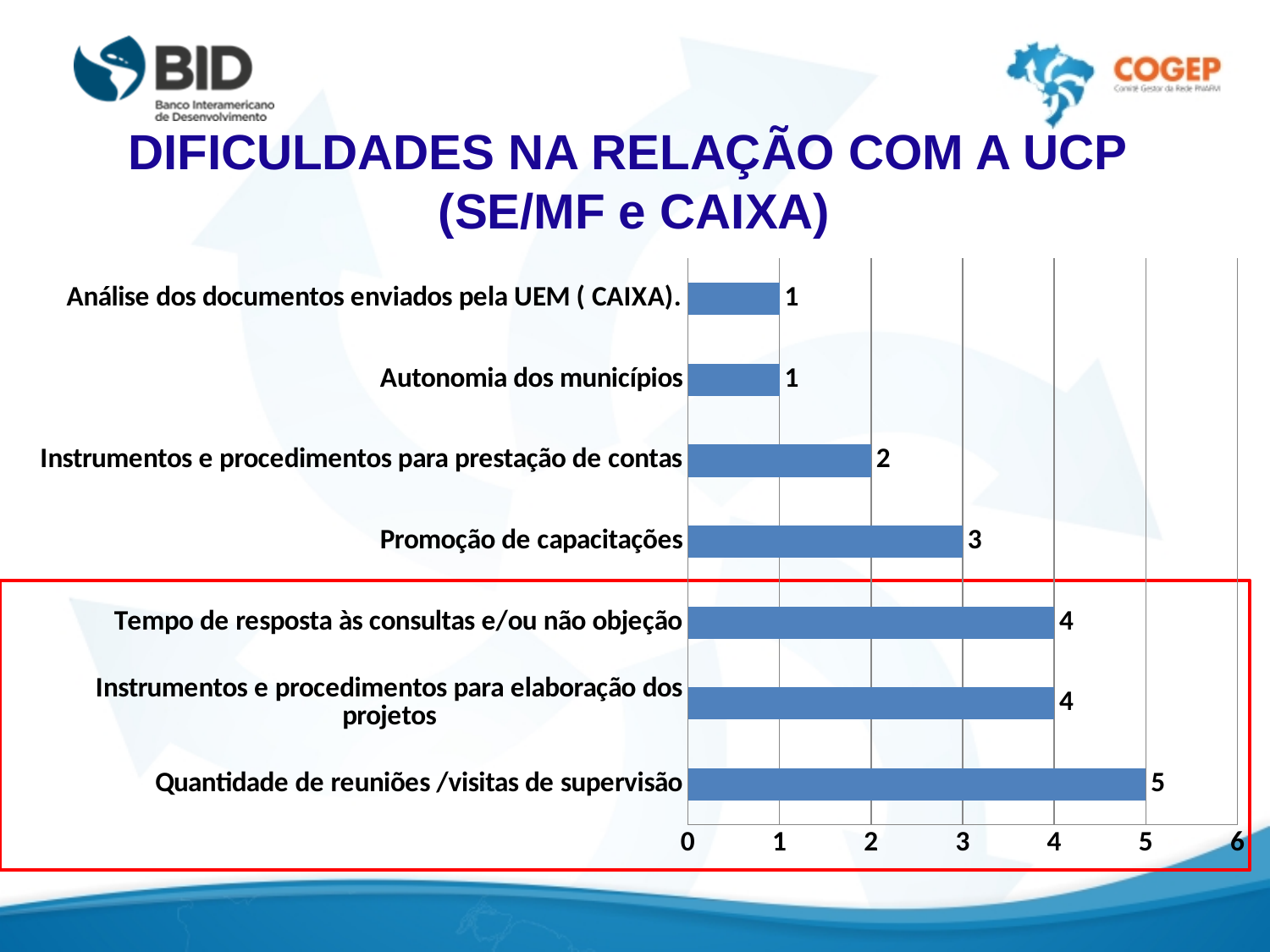
What is the highest value shown on the horizontal axis? 6 What is the difference between the values for "Quantidade de reuniões /visitas de supervisão" and "Promoção de capacitações"? 2 What kind of chart is shown on the slide? Bar chart Which category has the highest value? Quantidade de reuniões /visitas de supervisão Which is larger, the value for "Promoção de capacitações" or the value for "Autonomia dos municípios"? Promoção de capacitações How many categories are shown in the chart? 7 What value is shown for "Tempo de resposta às consultas e/ou não objeção"? 4 What value is shown for "Promoção de capacitações"? 3 What value is shown for "Instrumentos e procedimentos para prestação de contas"? 2 What is the title of the slide containing the chart? DIFICULDADES NA RELAÇÃO COM A UCP (SE/MF e CAIXA) What value is shown for "Quantidade de reuniões /visitas de supervisão"? 5 What is the difference between the values for "Instrumentos e procedimentos para elaboração dos projetos" and "Análise dos documentos enviados pela UEM ( CAIXA)."? 3